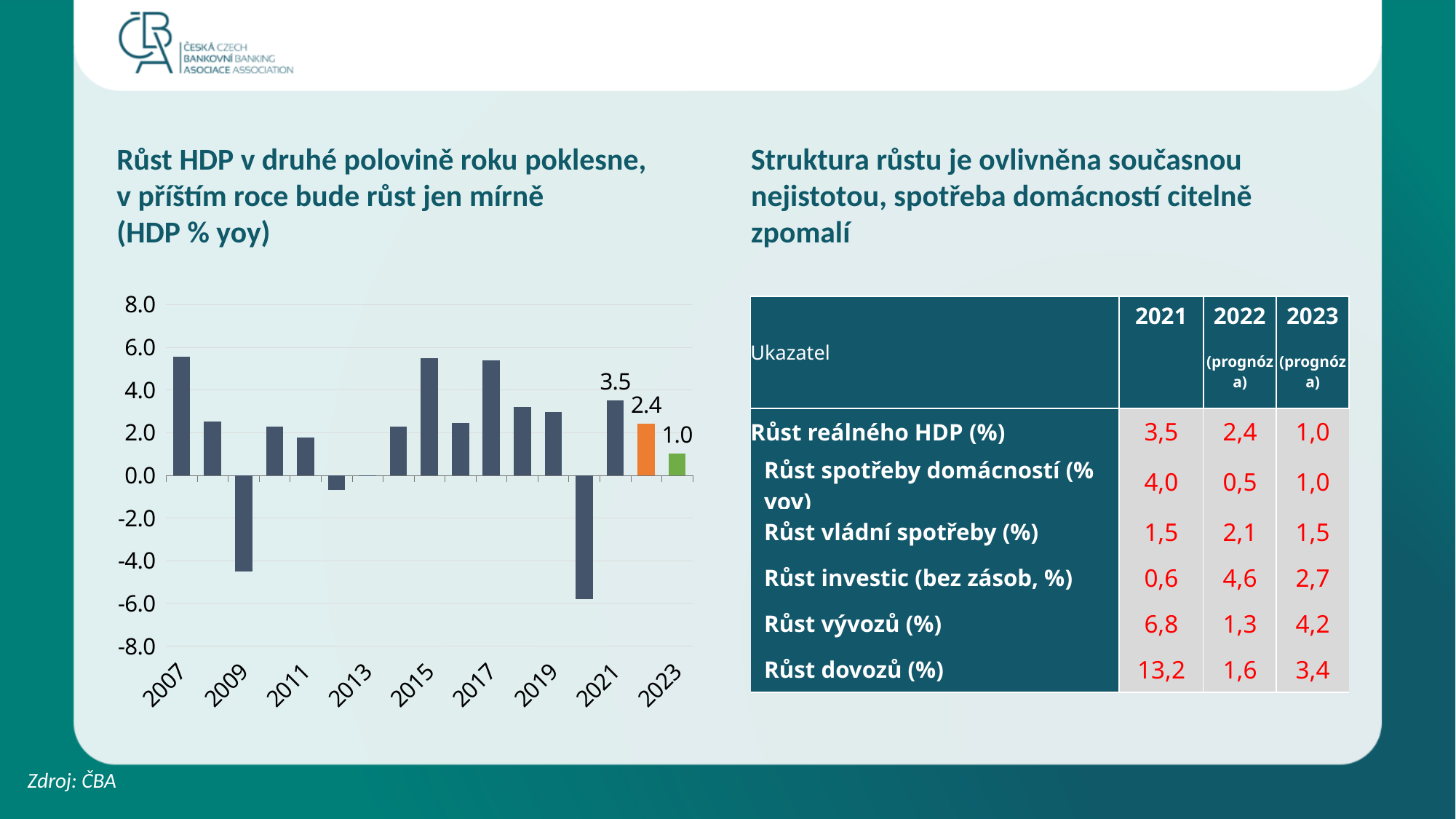
Do the values in the HDP % yoy bar chart rise or fall from 2021 to 2023? fall What is the difference between the values for 2022 and 2023 in the HDP % yoy bar chart? 1.4 What colour is the bar for 2022 in the HDP % yoy bar chart? orange What is the value for 2022 in the HDP % yoy bar chart? 2.4 Which is larger in the HDP % yoy bar chart, the value for 2021 or the value for 2022? 2021 What is the value for 2021 in the HDP % yoy bar chart? 3.5 What is the difference between the values for 2021 and 2022 in the HDP % yoy bar chart? 1.1 Is the value for 2009 in the HDP % yoy bar chart greater or less than -4.0? less What is the value for 2023 in the HDP % yoy bar chart? 1.0 Which year has the lowest value in the HDP % yoy bar chart? 2020 What kind of chart is shown on the left of the slide? bar chart Is the value for 2007 in the HDP % yoy bar chart greater or less than 4.0? greater